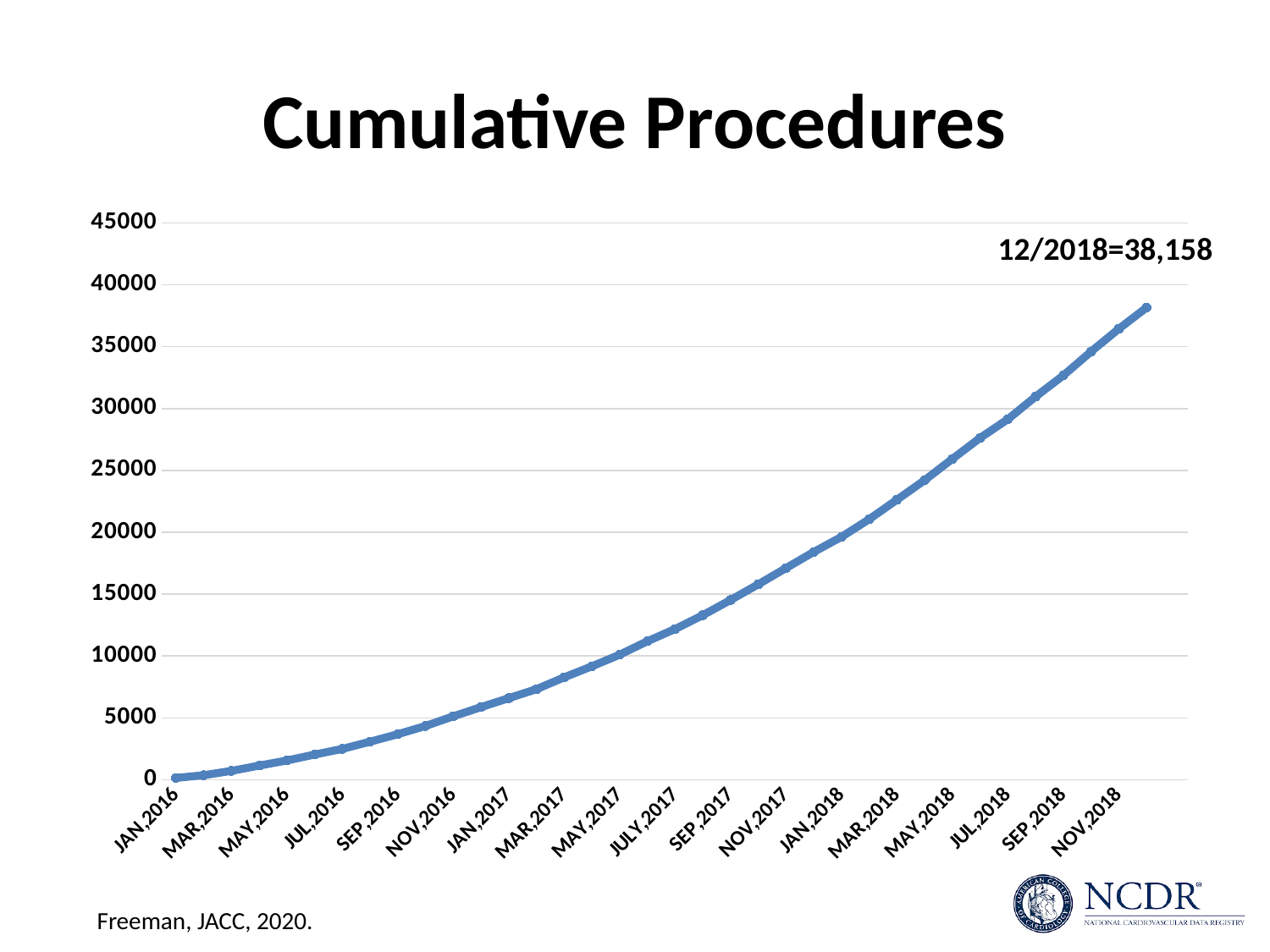
Which is larger, the value for JAN,2018 or the value for JAN,2017? JAN,2018 Is the value for JUL,2016 greater or less than 5000? less Is the value for NOV,2018 greater or less than 35000? greater Which labelled month on the x axis has the lowest value? JAN,2016 Do the values rise or fall along the x axis from JAN,2016 to the end of the series? rise What is the cumulative procedures value for 12/2018, as annotated on the chart? 38,158 Is the value for JAN,2017 greater or less than 5000? greater How many month labels are printed along the x axis? 18 What kind of chart is shown on the slide? line chart What is the title of the chart? Cumulative Procedures